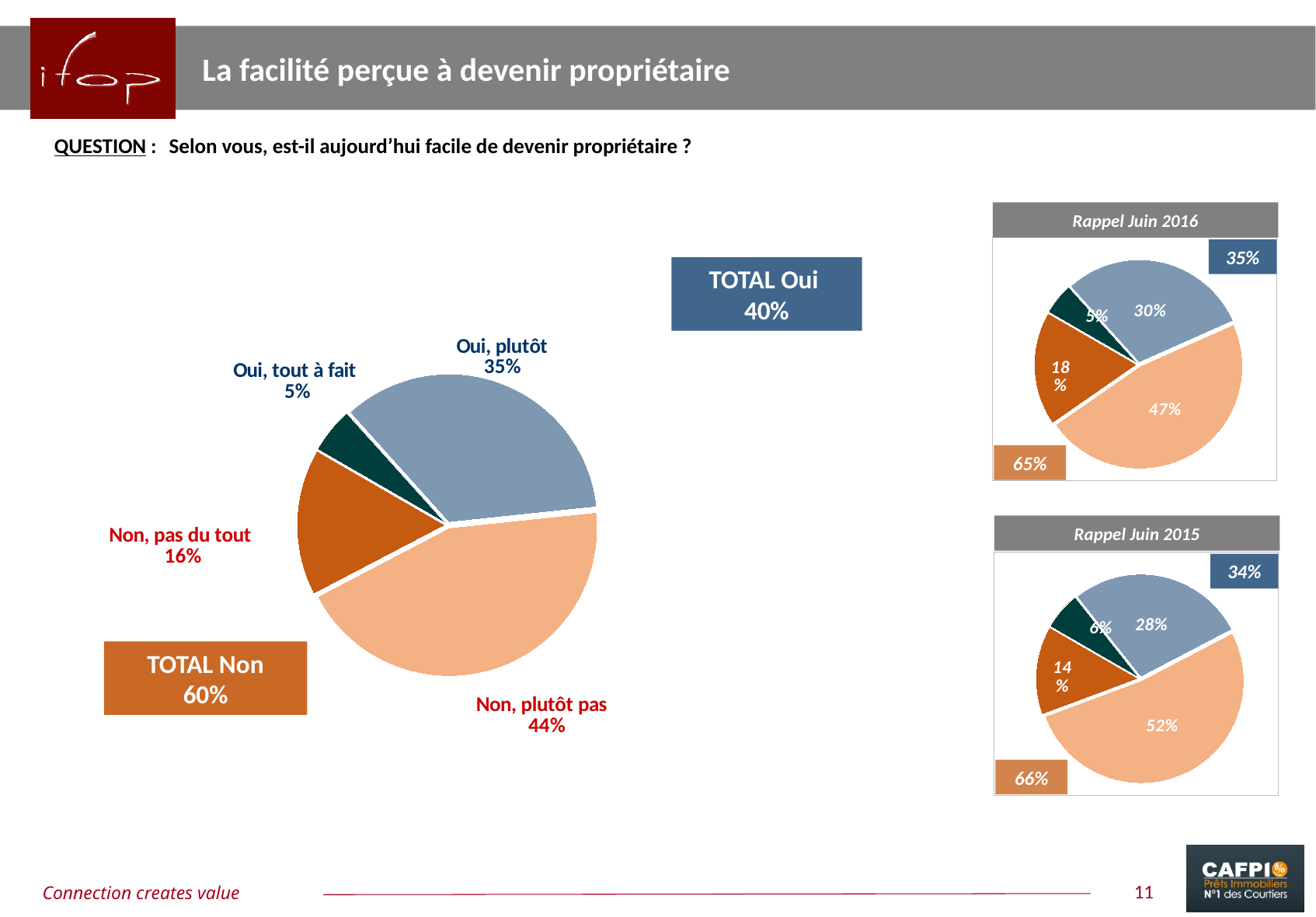
In the large pie chart, what percentage of respondents answered "Non, pas du tout"? 16% What type of chart is used on this slide to show the responses? Pie chart How many slices does the large pie chart have? 4 In the large pie chart, which response has the smallest share? Oui, tout à fait In the large pie chart, which is larger: "Oui, plutôt" or "Non, pas du tout"? Oui, plutôt In the large pie chart, what percentage of respondents answered "Oui, tout à fait"? 5% What is the TOTAL Oui value shown next to the large pie chart? 40% In the "Rappel Juin 2016" chart, what is the value of the largest slice? 47% In the large pie chart, what percentage of respondents answered "Non, plutôt pas"? 44% In the large pie chart, what is the difference in percentage points between "Oui, plutôt" and "Non, pas du tout"? 19 In the large pie chart, which response has the largest share? Non, plutôt pas In the "Rappel Juin 2015" chart, what total is shown in the orange box at the bottom left? 66%